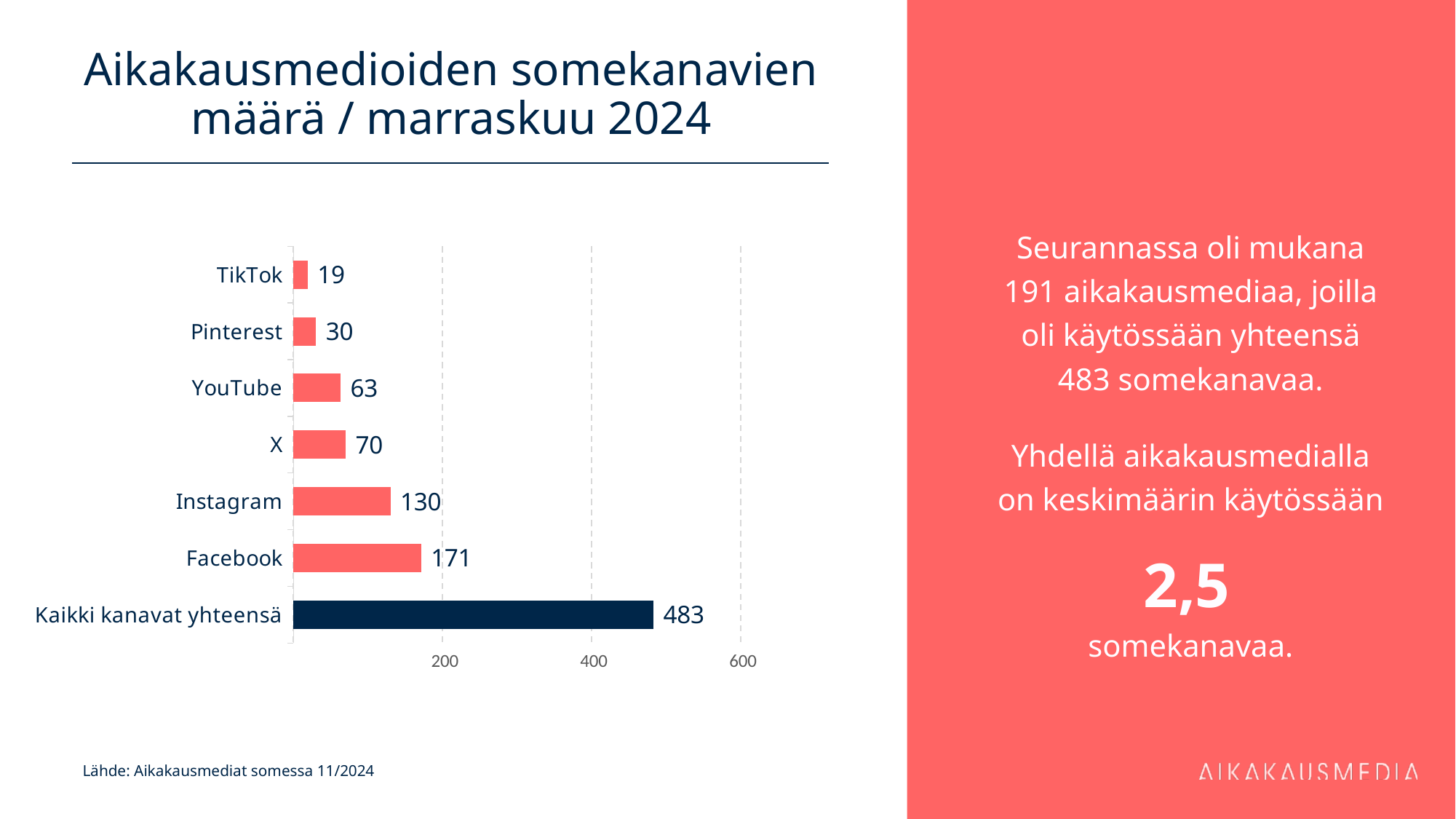
What is the title of the chart on the slide? Aikakausmedioiden somekanavien määrä / marraskuu 2024 What is the value for Kaikki kanavat yhteensä? 483 Which category has the lowest value? TikTok Which is larger, the value for X or the value for YouTube? X What is the value for Facebook? 171 What is the value for Instagram? 130 What is the value for TikTok? 19 How many categories are shown on the chart? 7 What is the difference between the values for Facebook and Instagram? 41 Which individual channel (excluding the total bar) has the highest value? Facebook What kind of chart is shown on the slide? bar chart Is the value for Kaikki kanavat yhteensä greater or less than 400? greater